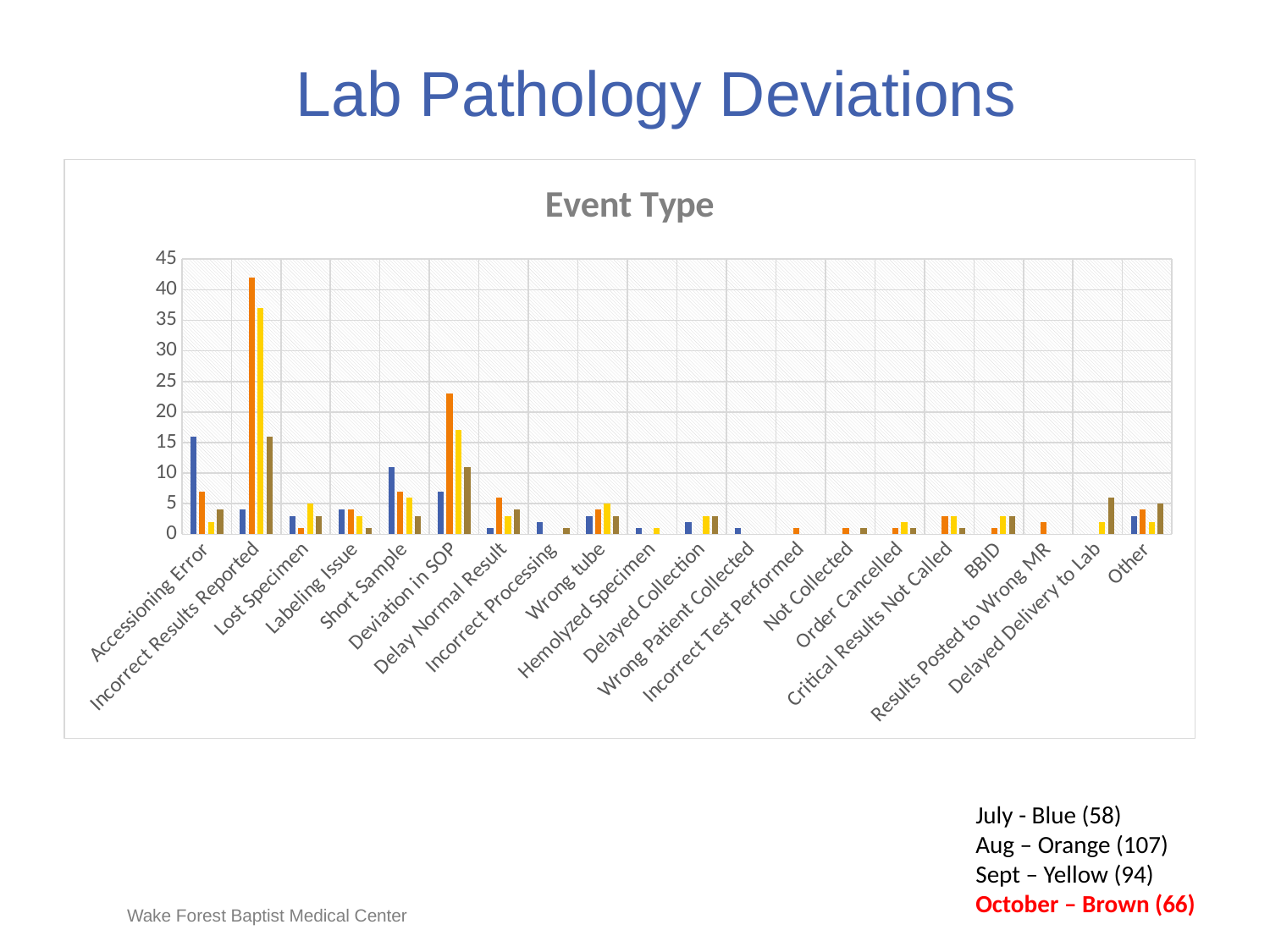
Which month has the highest bar for Incorrect Results Reported? Aug (Orange) What is the title of the chart? Event Type Which event type has the tallest bar in the chart? Incorrect Results Reported Is the Aug (orange) value for Incorrect Results Reported greater or less than 35? greater For Deviation in SOP, which is larger: the Aug (orange) bar or the Sept (yellow) bar? Aug (orange) How many event type categories are shown on the x axis of the chart? 20 Is the July (blue) value for Accessioning Error greater or less than 10? greater How many months (series) are listed in the colour key below the chart? 4 According to the colour key, what is the difference between the Aug total (107) and the Sept total (94)? 13 Is the Aug (orange) value for Deviation in SOP greater or less than 20? greater What kind of chart is shown on the slide? bar chart For Accessioning Error, which is larger: the July (blue) bar or the Aug (orange) bar? July (blue)